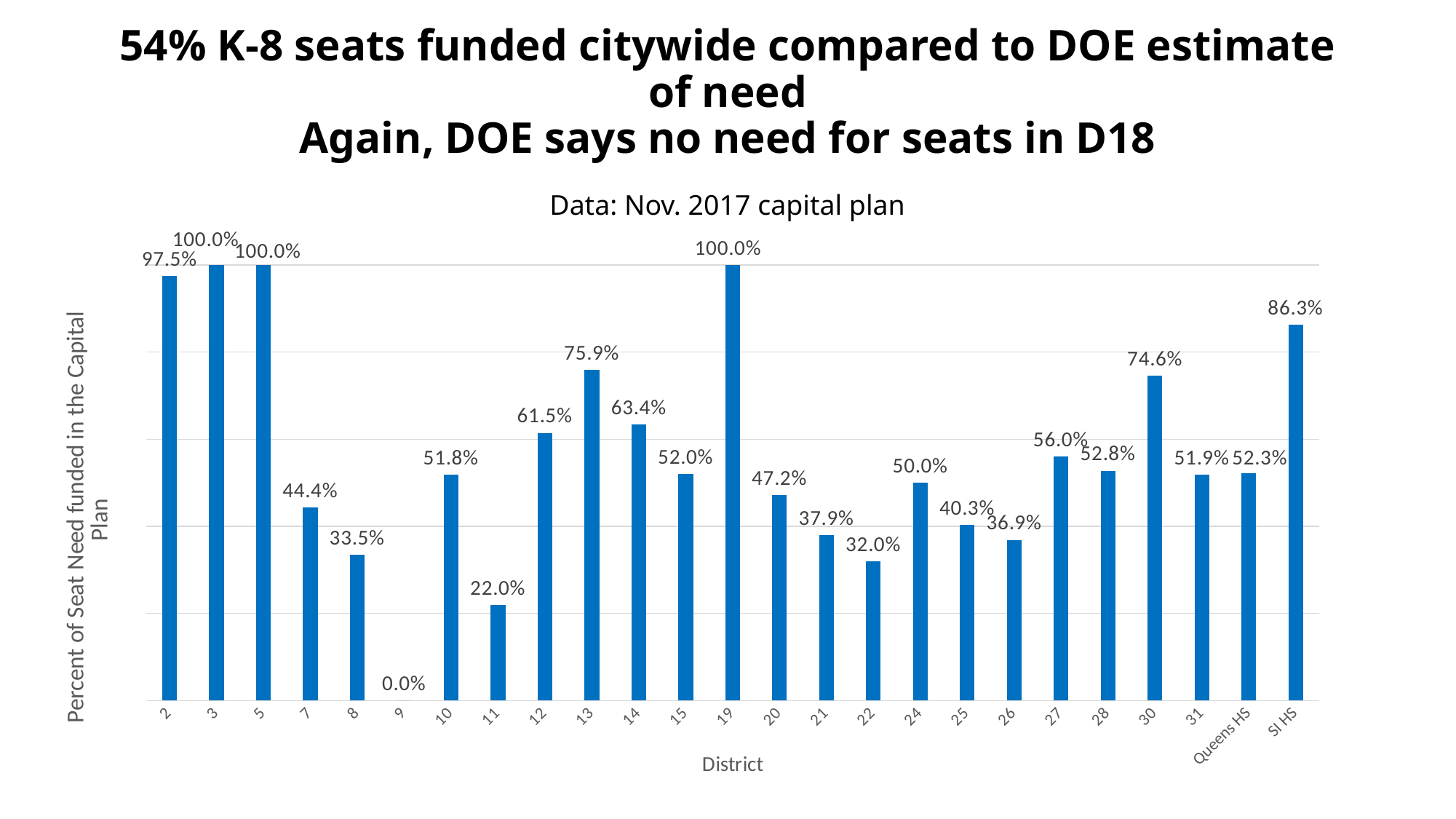
What is the label of the y axis? Percent of Seat Need funded in the Capital Plan Which district has the lowest percent of seat need funded? 9 What kind of chart is shown on the slide? bar chart What is the value for district 11? 22.0% What is the value for Queens HS? 52.3% What is the difference between the values for district 2 and district 7? 53.1% How many categories are shown on the x axis? 25 Which has a higher value, district 8 or district 21? 21 Which has a higher value, district 12 or district 14? 14 What is the difference between the values for district 30 and district 22? 42.6% What is the value for district 13? 75.9% What is the value for SI HS? 86.3%